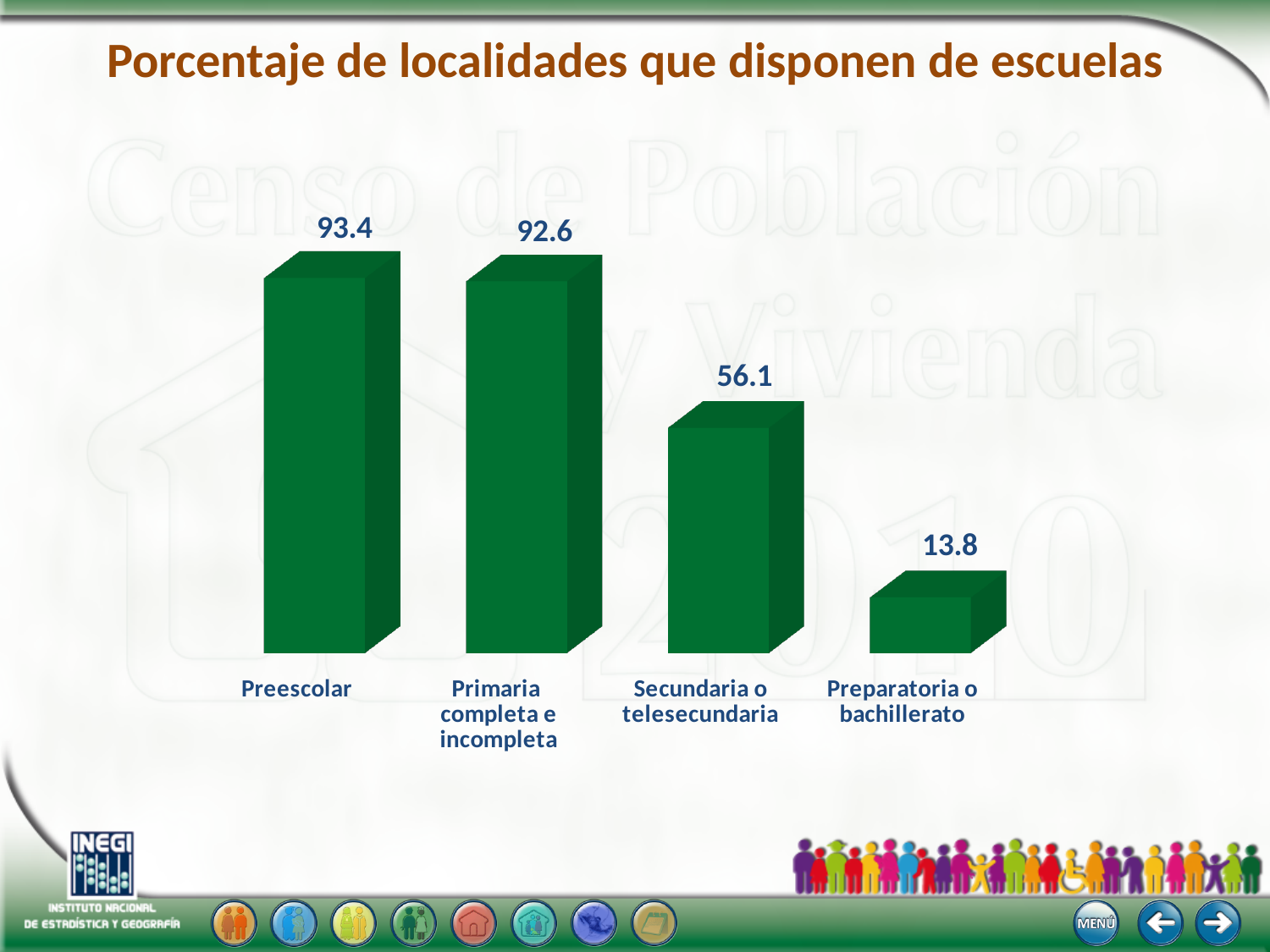
What is the value for Preparatoria o bachillerato? 13.8 Which category has the highest value? Preescolar What is the value for Primaria completa e incompleta? 92.6 What is the difference between the values for Secundaria o telesecundaria and Preparatoria o bachillerato? 42.3 Which category has the lowest value? Preparatoria o bachillerato What is the value for Secundaria o telesecundaria? 56.1 What is the value for Preescolar? 93.4 What is the title of the chart? Porcentaje de localidades que disponen de escuelas What is the difference between the values for Preescolar and Primaria completa e incompleta? 0.8 How many categories are shown in the chart? 4 What kind of chart is shown on the slide? Bar chart Which is larger, the value for Secundaria o telesecundaria or the value for Preparatoria o bachillerato? Secundaria o telesecundaria